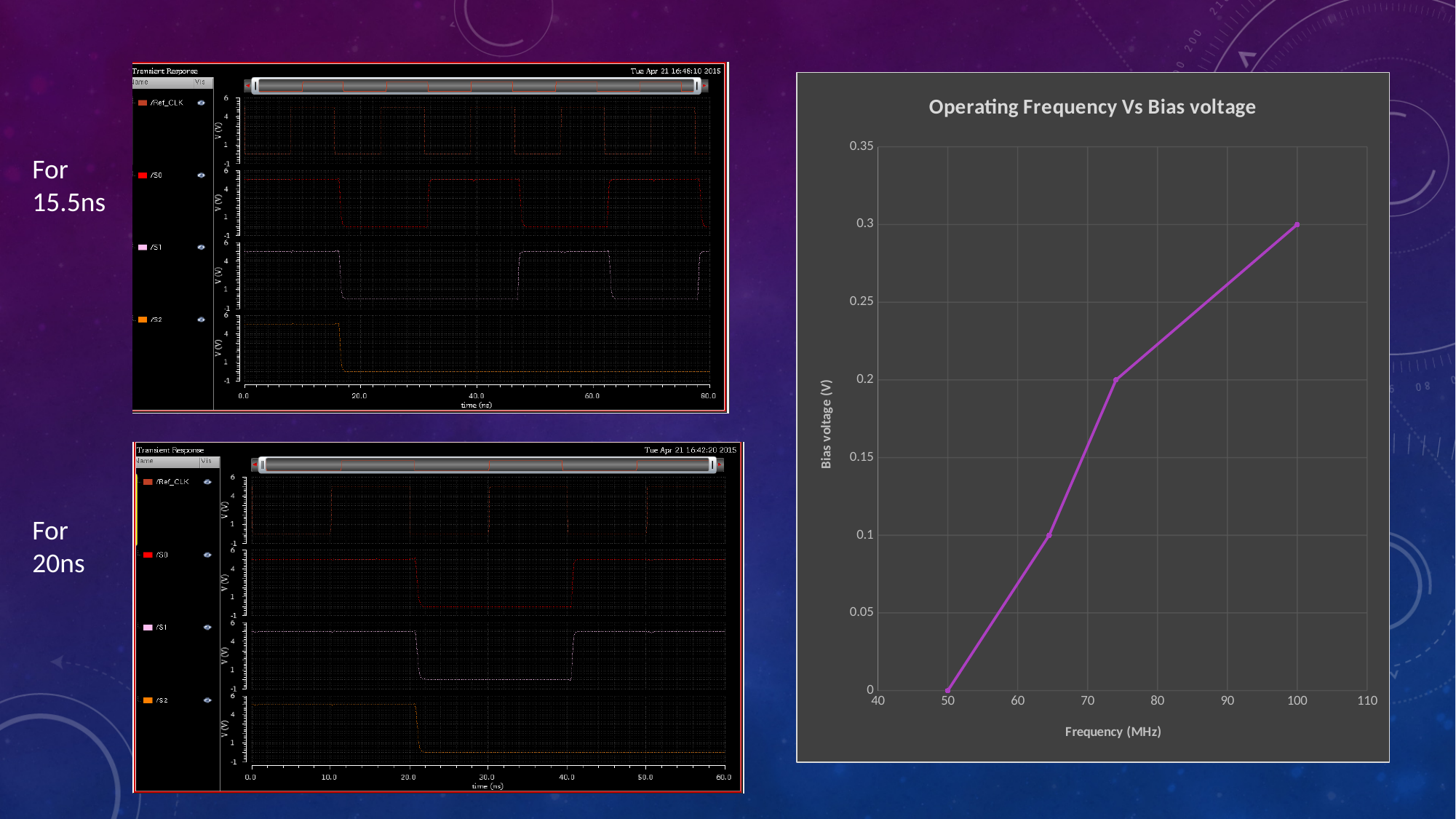
In the 'Operating Frequency Vs Bias voltage' chart, is the bias voltage at about 65 MHz greater or less than 0.15? less In the 'Operating Frequency Vs Bias voltage' chart, does the bias voltage rise or fall as frequency increases? rises In the 'Operating Frequency Vs Bias voltage' chart, at which frequency is the bias voltage highest? 100 MHz What kind of chart is the 'Operating Frequency Vs Bias voltage' chart? line chart In the 'Operating Frequency Vs Bias voltage' chart, what is the bias voltage at 100 MHz? 0.3 In the 'Operating Frequency Vs Bias voltage' chart, at which frequency is the bias voltage lowest? 50 MHz In the 'Operating Frequency Vs Bias voltage' chart, what is the bias voltage at 50 MHz? 0 What is the label of the vertical axis in the 'Operating Frequency Vs Bias voltage' chart? Bias voltage (V) How many data points are plotted in the 'Operating Frequency Vs Bias voltage' chart? 4 What is the label of the horizontal axis in the 'Operating Frequency Vs Bias voltage' chart? Frequency (MHz) In the 'Operating Frequency Vs Bias voltage' chart, which has the larger bias voltage: 100 MHz or 50 MHz? 100 MHz